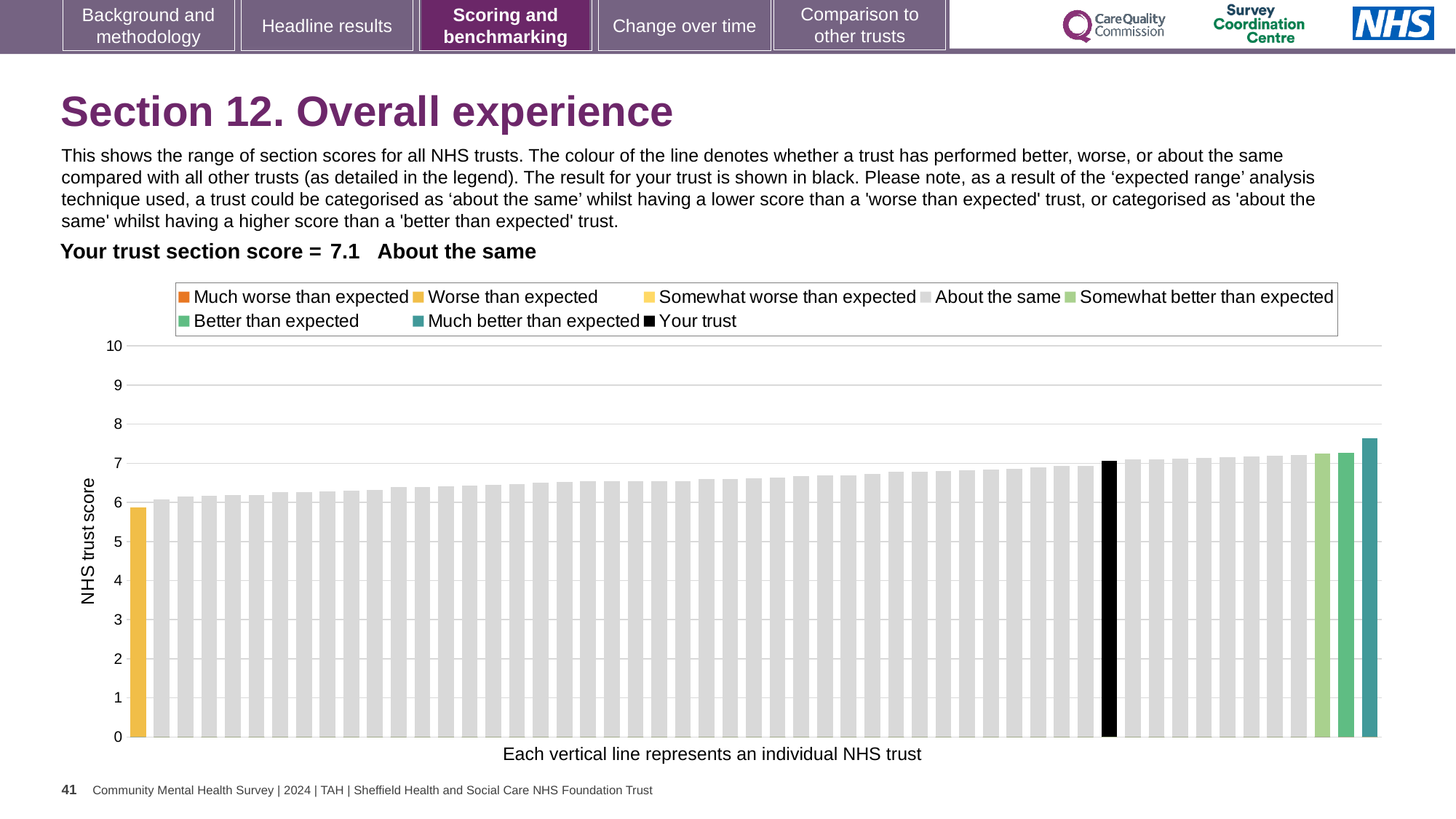
Is the value for the rightmost bar greater or less than 7? greater How many entries does the chart legend list? 8 Which legend category does the highest-scoring trust (rightmost bar) belong to? Much better than expected Which legend category does the lowest-scoring trust (leftmost bar) belong to? Worse than expected What colour is used to show your trust in the chart? Black What is the section score for your trust shown on the slide? 7.1 What is the label on the y axis of the chart? NHS trust score Is the value for the leftmost bar greater or less than 7? less Do the trust scores rise or fall from left to right along the x axis? Rise Is the value for your trust (the black bar) greater or less than 7? greater How is your trust's section score categorised compared with other trusts? About the same What kind of chart is shown on the slide? Bar chart